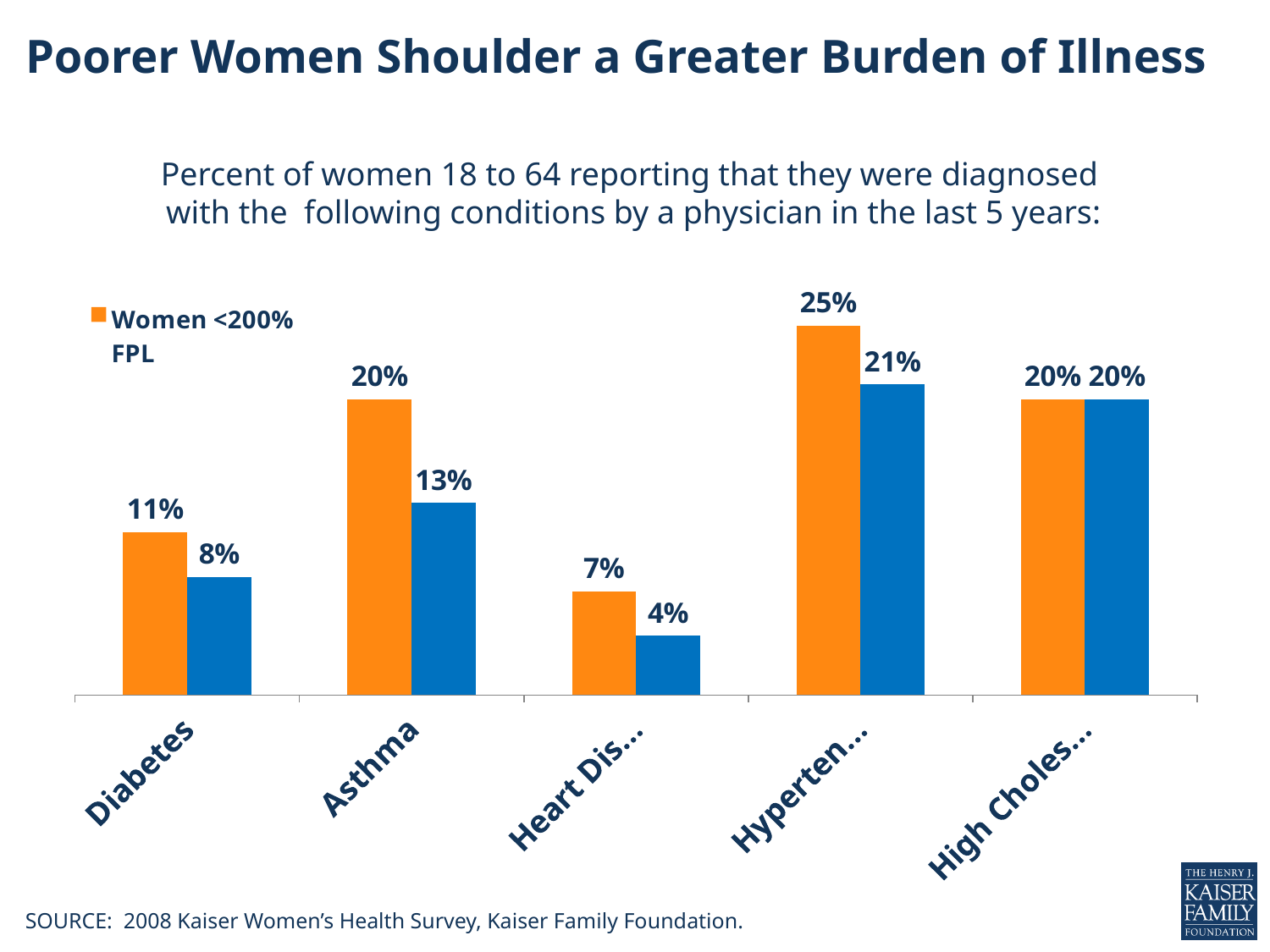
Which condition has the highest value for Women <200% FPL? Hyperten... How many conditions are shown on the x axis? 5 What is the legend entry shown for the orange bars? Women <200% FPL What is the value of the blue bar for Asthma? 13% What is the value of the orange (Women <200% FPL) bar for the category labelled "Hyperten..."? 25% What is the difference between the Women <200% FPL values for Diabetes and Asthma? 9% For Diabetes, which is larger: the orange bar or the blue bar? The orange bar (Women <200% FPL) Which condition has the lowest value among the blue bars? Heart Dis... What is the difference between the orange and blue bars for Asthma? 7% What percent of women <200% FPL reported being diagnosed with Diabetes? 11% For which condition are the orange and blue bars equal? High Choles... What type of chart is shown on the slide? Bar chart